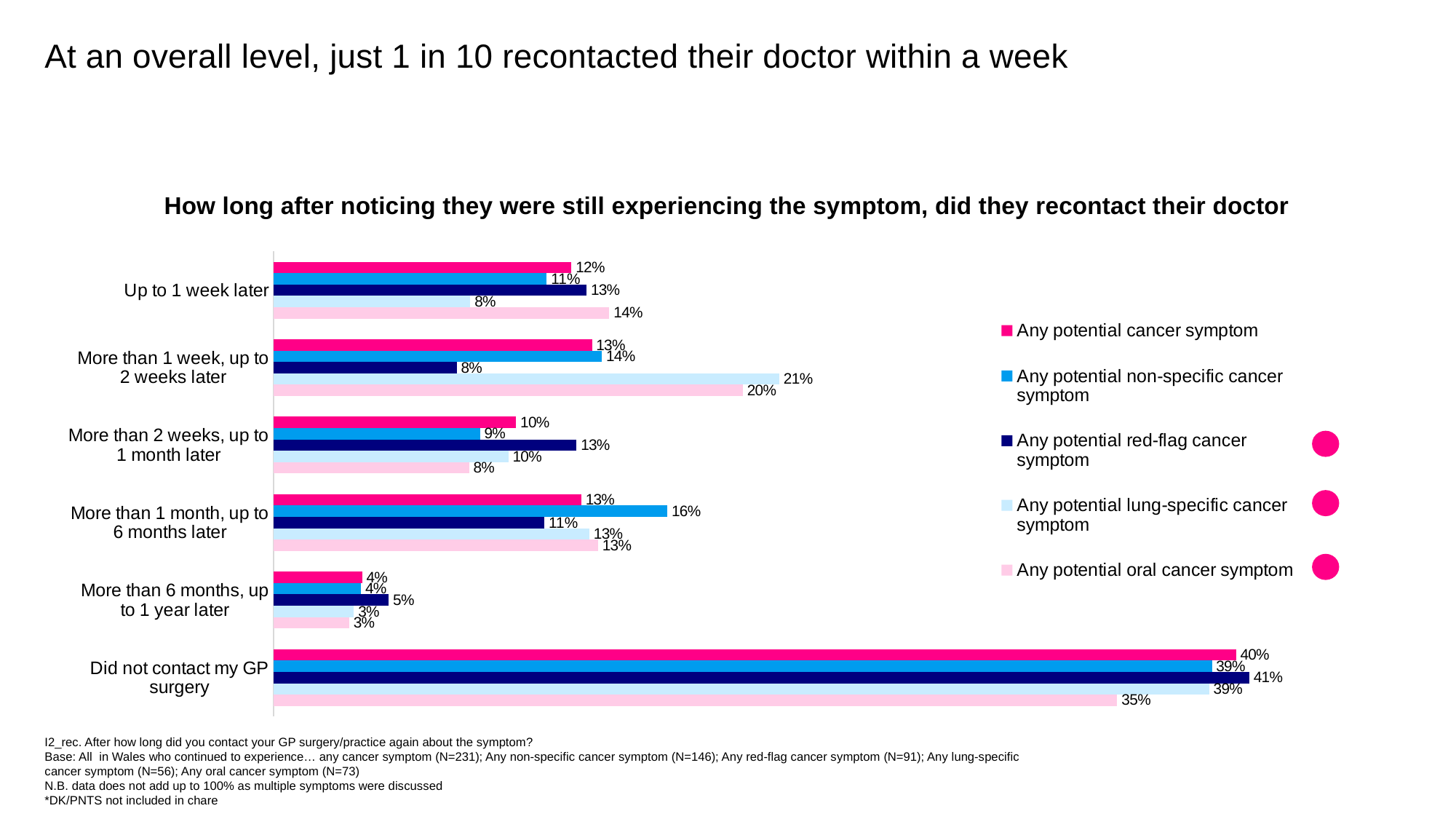
How many categories are shown on the chart? 6 Which series has the lowest value in the 'Up to 1 week later' category? Any potential lung-specific cancer symptom What is the value for 'Any potential oral cancer symptom' in the 'Did not contact my GP surgery' category? 35% What is the difference between the 'Any potential lung-specific cancer symptom' and 'Any potential red-flag cancer symptom' values in the 'More than 1 week, up to 2 weeks later' category? 13% What kind of chart is shown on the slide? Bar chart What is the value for 'Any potential red-flag cancer symptom' in the 'Up to 1 week later' category? 13% Which series has the highest value in the 'Did not contact my GP surgery' category? Any potential red-flag cancer symptom Which category has the highest value for 'Any potential cancer symptom'? Did not contact my GP surgery What is the title of the chart? How long after noticing they were still experiencing the symptom, did they recontact their doctor In the 'More than 1 month, up to 6 months later' category, which is larger: 'Any potential non-specific cancer symptom' or 'Any potential red-flag cancer symptom'? Any potential non-specific cancer symptom How many series does the legend list? 5 What is the value for 'Any potential lung-specific cancer symptom' in the 'More than 1 week, up to 2 weeks later' category? 21%